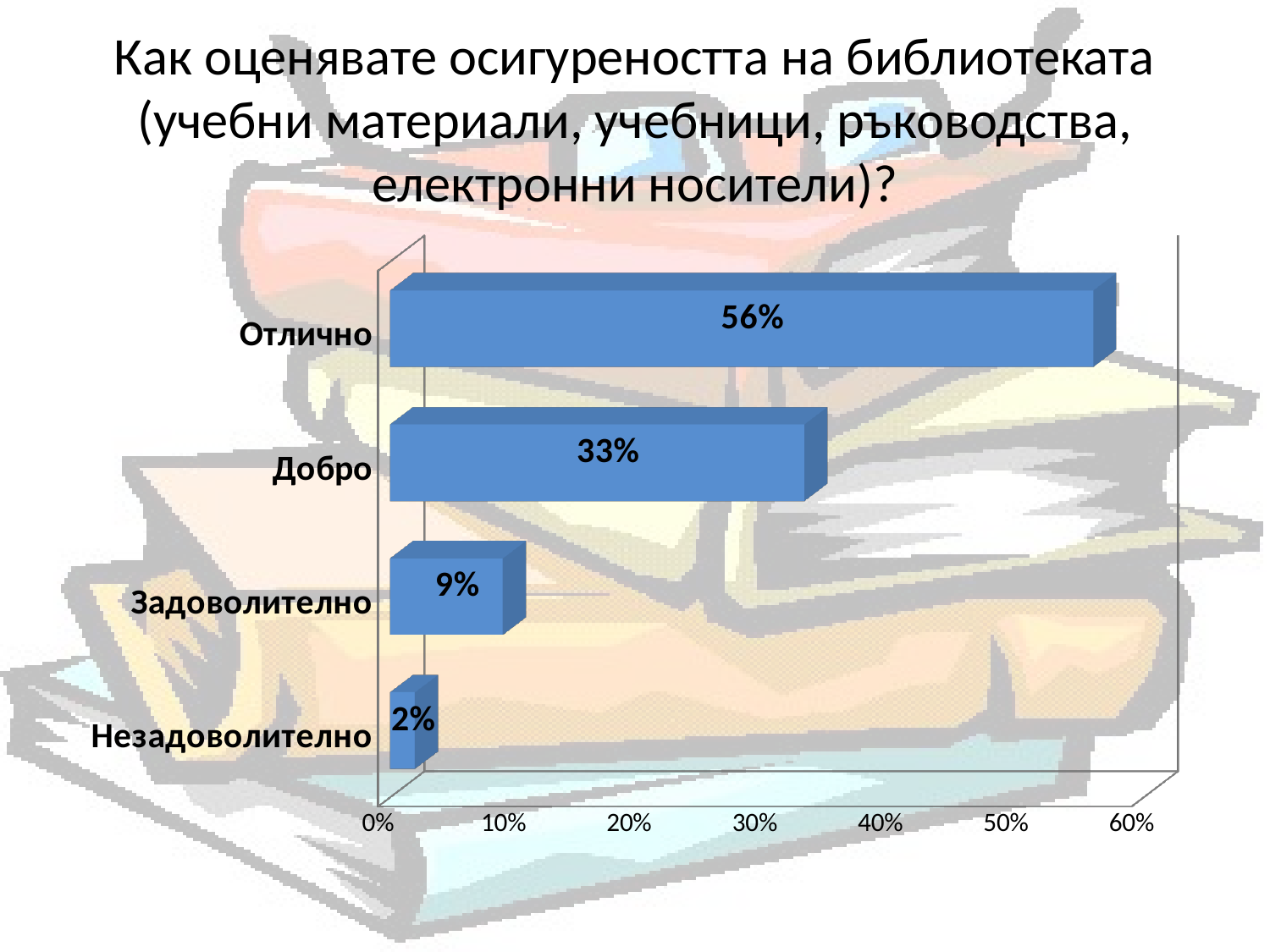
What kind of chart is shown on the slide? bar chart What is the difference between the values for Отлично and Добро? 23% How many categories are shown in the chart? 4 Which category has the highest value? Отлично What is the value for Задоволително? 9% Which category has the lowest value? Незадоволително What is the difference between the values for Задоволително and Незадоволително? 7% What is the value for Отлично? 56% Is the value for Добро greater or less than 30%? greater What is the value for Добро? 33% What is the value for Незадоволително? 2% Which is larger, the value for Добро or the value for Задоволително? Добро